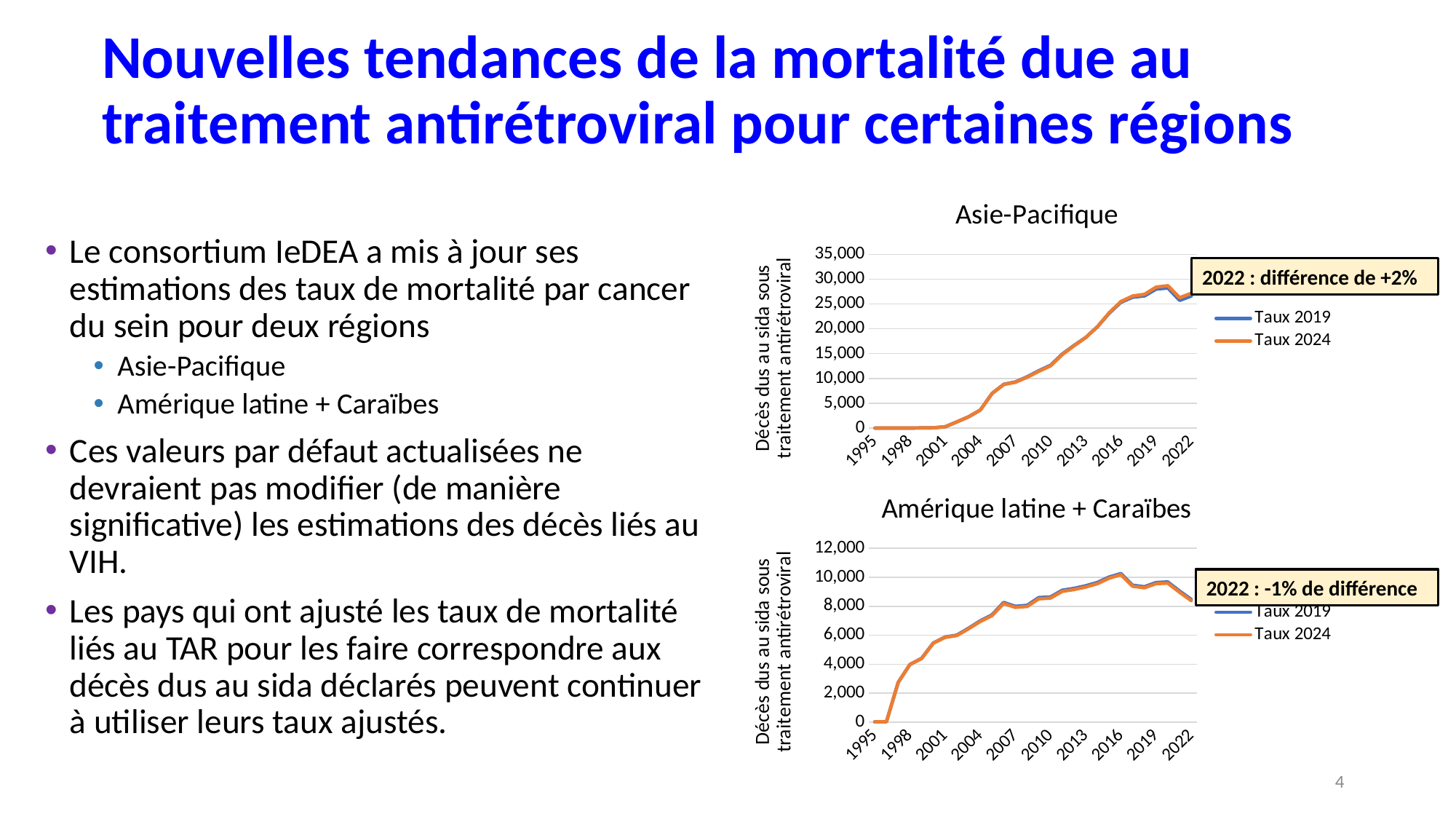
What difference for 2022 is annotated on the Amérique latine + Caraïbes chart? -1% In the Asie-Pacifique chart, is the value for 2013 greater or less than 15,000? greater In the Asie-Pacifique chart, is the value for 2022 greater or less than 25,000? greater In the Amérique latine + Caraïbes chart, is the value for 1995 greater or less than 2,000? less In the Amérique latine + Caraïbes chart, do the values rise or fall from 2016 to 2022? fall How many series does the legend of the Amérique latine + Caraïbes chart list? 2 In the Asie-Pacifique chart, do the values generally rise or fall from 1995 to 2019? rise What difference for 2022 is annotated on the Asie-Pacifique chart? +2% What kind of chart is the Asie-Pacifique chart? line chart